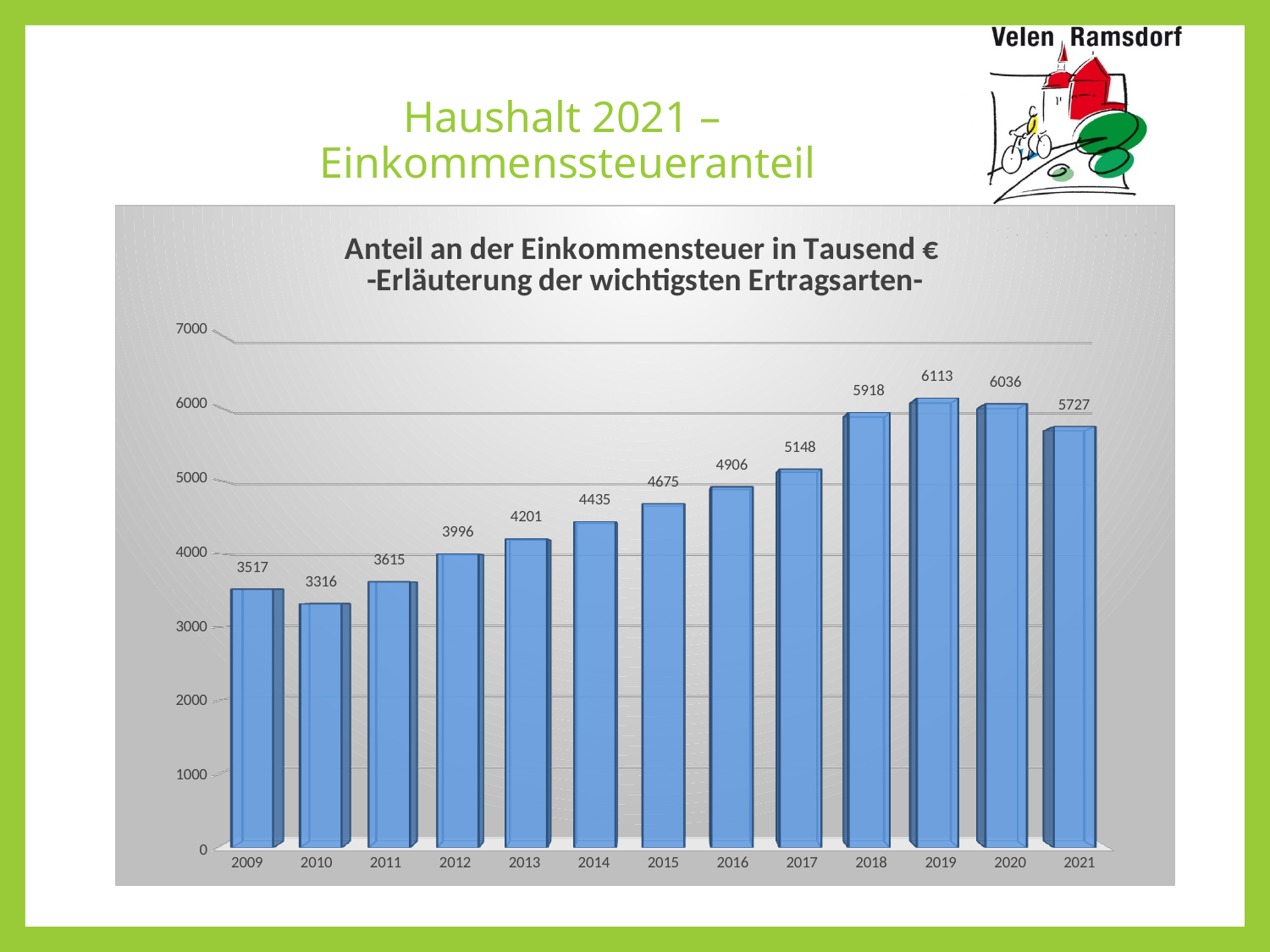
What is the value for 2009? 3517 How many years are shown on the x axis? 13 Which is larger, the value for 2018 or the value for 2020? 2020 Which year has the highest value? 2019 What kind of chart is shown? bar chart Which year has the lowest value? 2010 Is the value for 2017 greater or less than 5000? greater What is the difference between the values for 2010 and 2009? 201 What is the value for 2021? 5727 Do the values generally rise or fall from 2010 to 2019? rise What is the value for 2015? 4675 What is the difference between the values for 2019 and 2021? 386